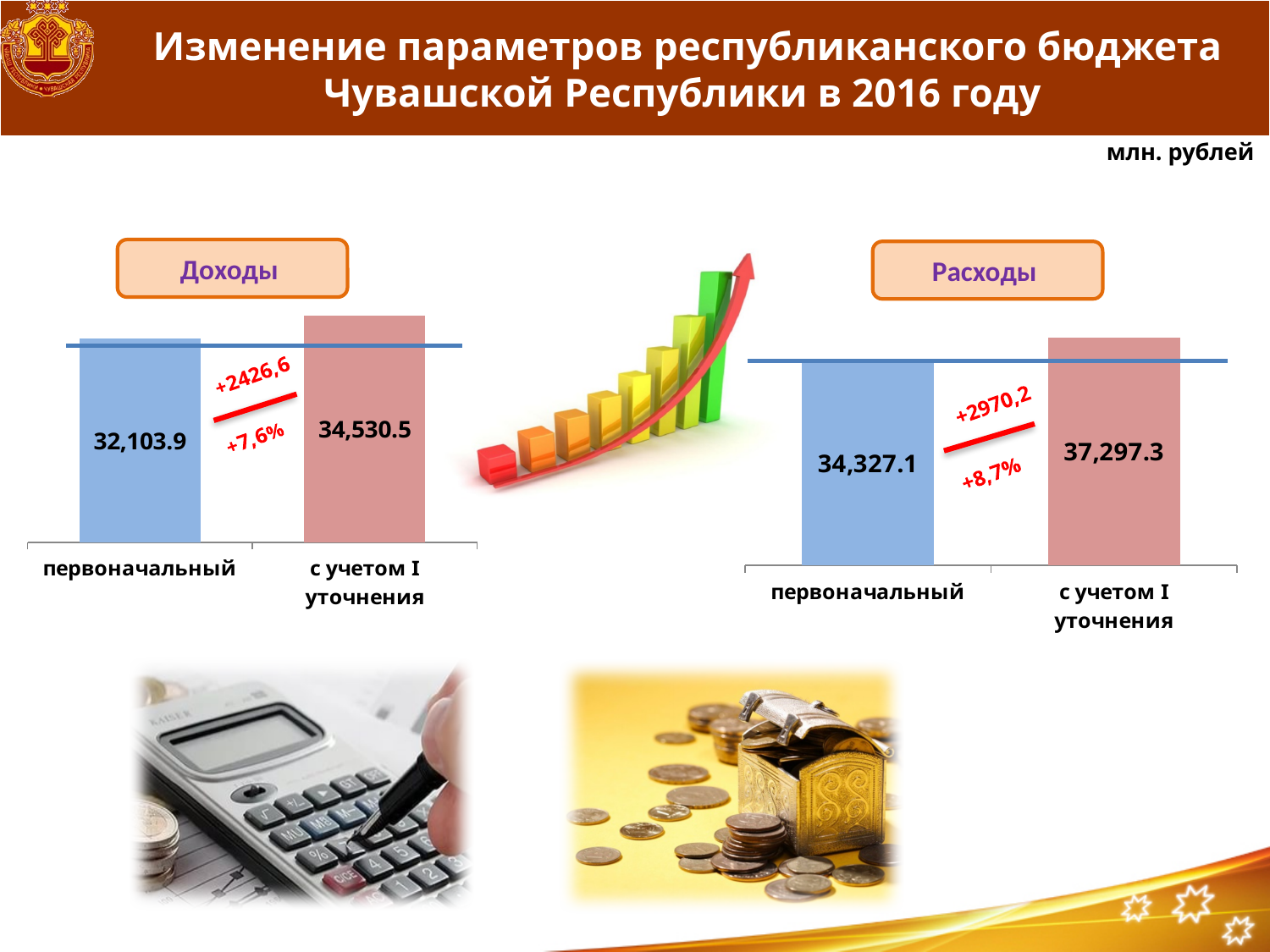
In the Расходы chart, which category has the lower value? первоначальный In the Доходы chart, what is the value for с учетом I уточнения? 34,530.5 In the Доходы chart, which category has the higher value? с учетом I уточнения In the Доходы chart, what is the value for первоначальный? 32,103.9 In the Расходы chart, what is the difference between с учетом I уточнения and первоначальный? 2,970.2 In the Расходы chart, what is the value for первоначальный? 34,327.1 How many bars does the Расходы chart have? 2 What percentage change is annotated in the Расходы chart? +8,7% What type of chart is the Доходы chart? bar chart Which is larger: первоначальный in the Расходы chart or с учетом I уточнения in the Доходы chart? с учетом I уточнения in the Доходы chart In the Доходы chart, what is the difference between с учетом I уточнения and первоначальный? 2,426.6 In the Расходы chart, what is the value for с учетом I уточнения? 37,297.3